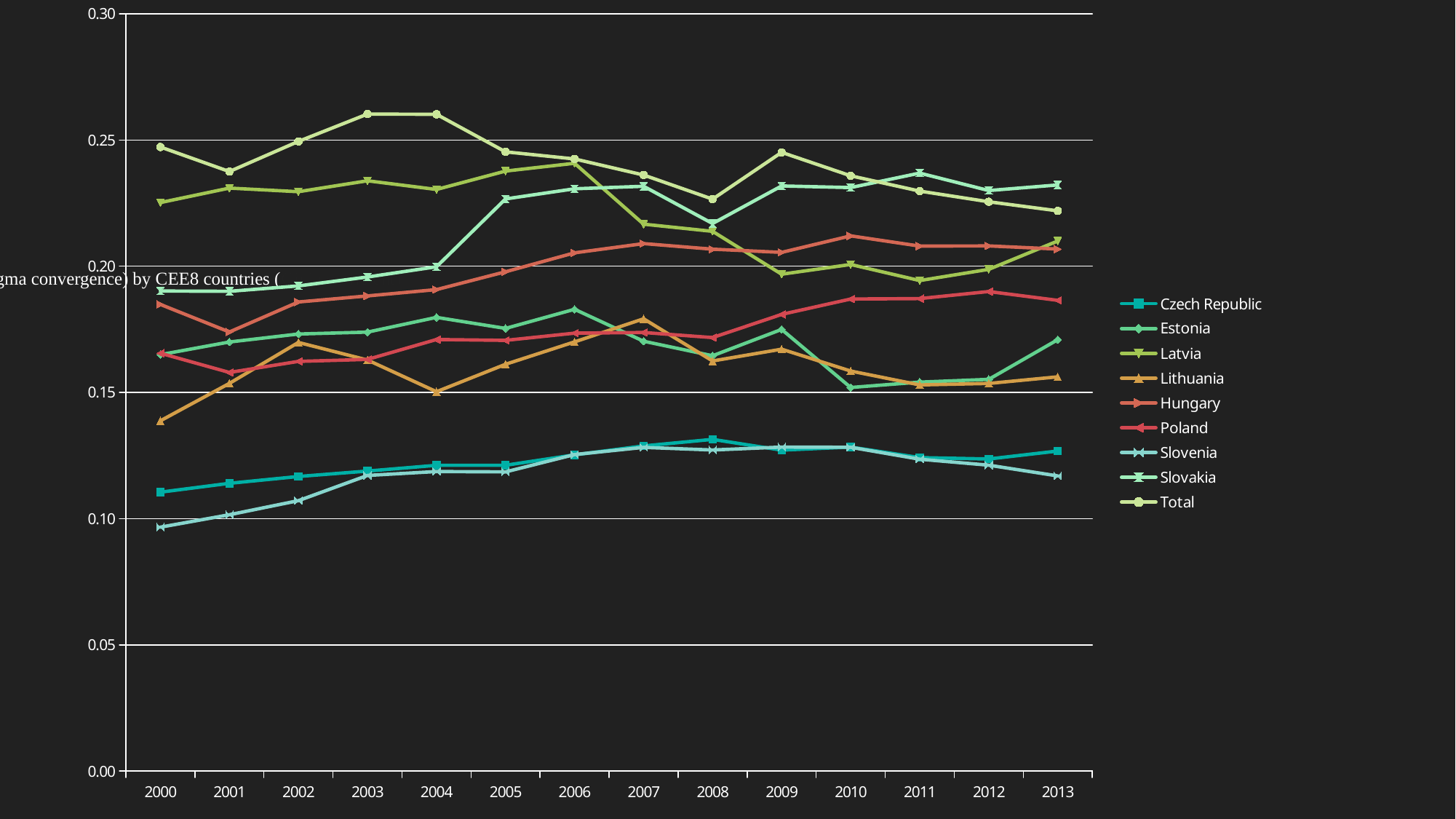
How many years are shown on the x axis? 14 Which series has the highest value in 2003? Total Does the Czech Republic line rise or fall from 2000 to 2008? rise What kind of chart is shown on the slide? line chart Which series has the lowest value in 2000? Slovenia In 2000, which is larger: the value for Total or the value for Czech Republic? Total How many series does the legend list? 9 Is the value for Slovenia in 2000 greater or less than 0.10? less Is the value for Total in 2003 greater or less than 0.25? greater Is the value for Czech Republic in 2000 greater or less than 0.15? less In 2013, which is larger: the value for Slovakia or the value for Poland? Slovakia